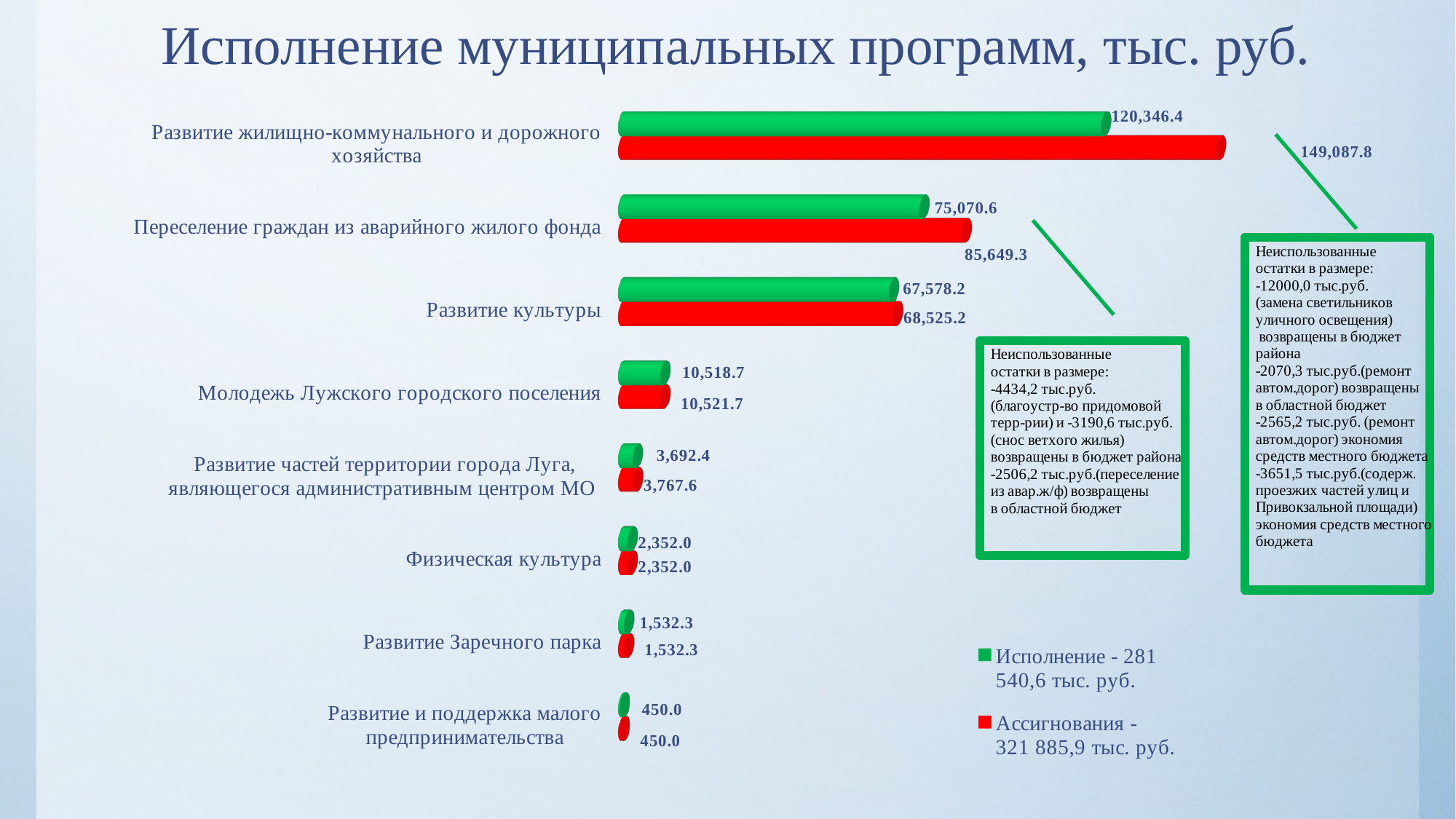
What type of chart is shown on the slide? Bar chart How many programs (categories) are shown in the chart? 8 What is the difference between Ассигнования and Исполнение for Переселение граждан из аварийного жилого фонда? 10,578.7 Which program has the lowest Исполнение value? Развитие и поддержка малого предпринимательства Which program has the highest Ассигнования value? Развитие жилищно-коммунального и дорожного хозяйства What is the Исполнение value for Развитие культуры? 67,578.2 What is the Ассигнования value for Переселение граждан из аварийного жилого фонда? 85,649.3 What is the Ассигнования value for Развитие частей территории города Луга, являющегося административным центром МО? 3,767.6 Which is larger for Развитие культуры: Исполнение or Ассигнования? Ассигнования What is the difference between Ассигнования and Исполнение for Развитие жилищно-коммунального и дорожного хозяйства? 28,741.4 How many series does the legend list? 2 What is the Исполнение value for Развитие жилищно-коммунального и дорожного хозяйства? 120,346.4